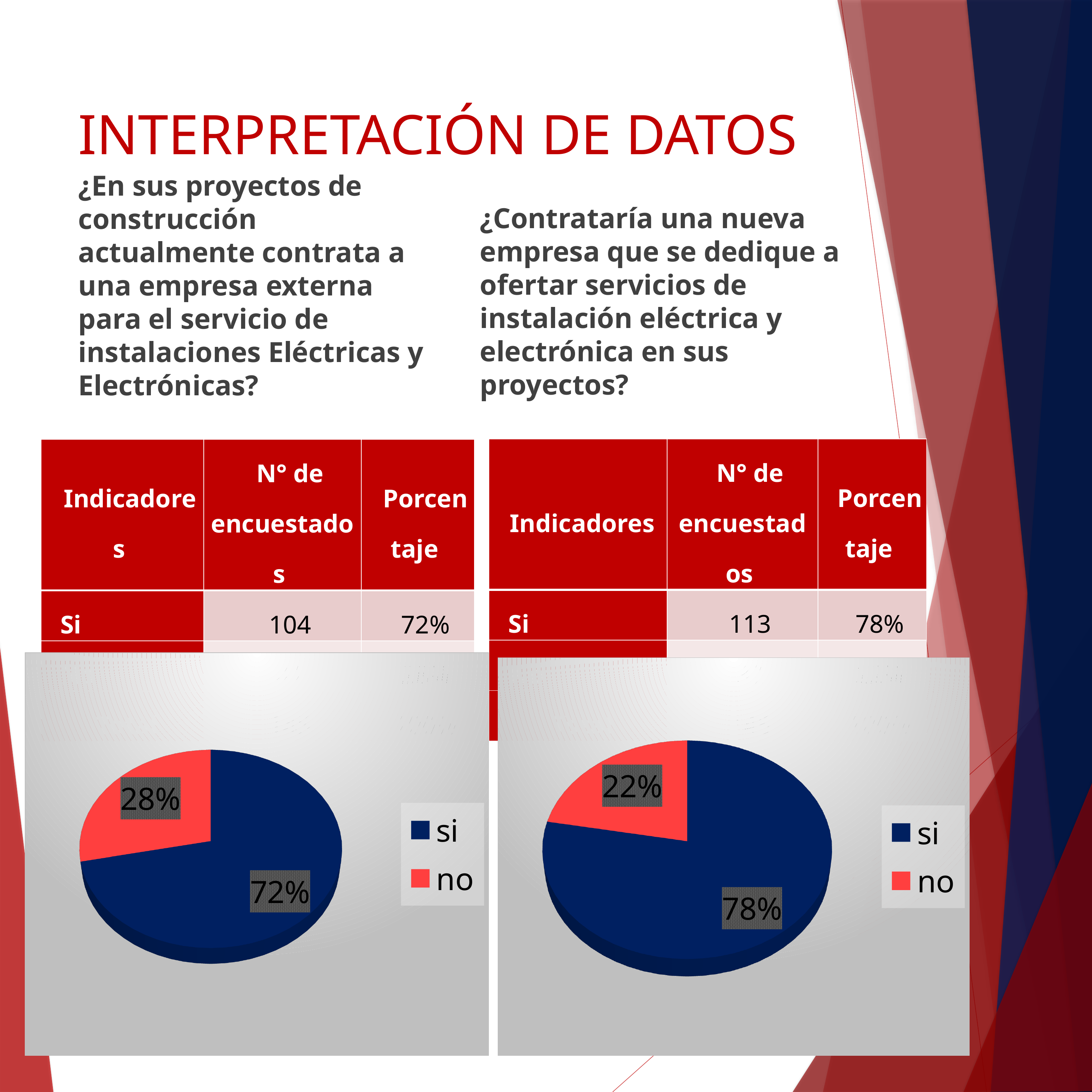
In the right pie chart, what is the difference between the "si" and "no" shares? 56% How many slices does the left pie chart have? 2 What type of chart is shown on the right side of the slide? pie chart What colour is the "no" slice in the right pie chart? red In the right pie chart, what is the share for "no"? 22% In the left pie chart, what is the share for "no"? 28% In the left pie chart, what is the share for "si"? 72% In the left pie chart, what is the difference between the "si" and "no" shares? 44% In the right pie chart, which slice is the smallest? no In the left pie chart, which slice is the largest? si In the right pie chart, what is the share for "si"? 78% Which is larger: the "si" share in the left pie chart or the "si" share in the right pie chart? the right pie chart